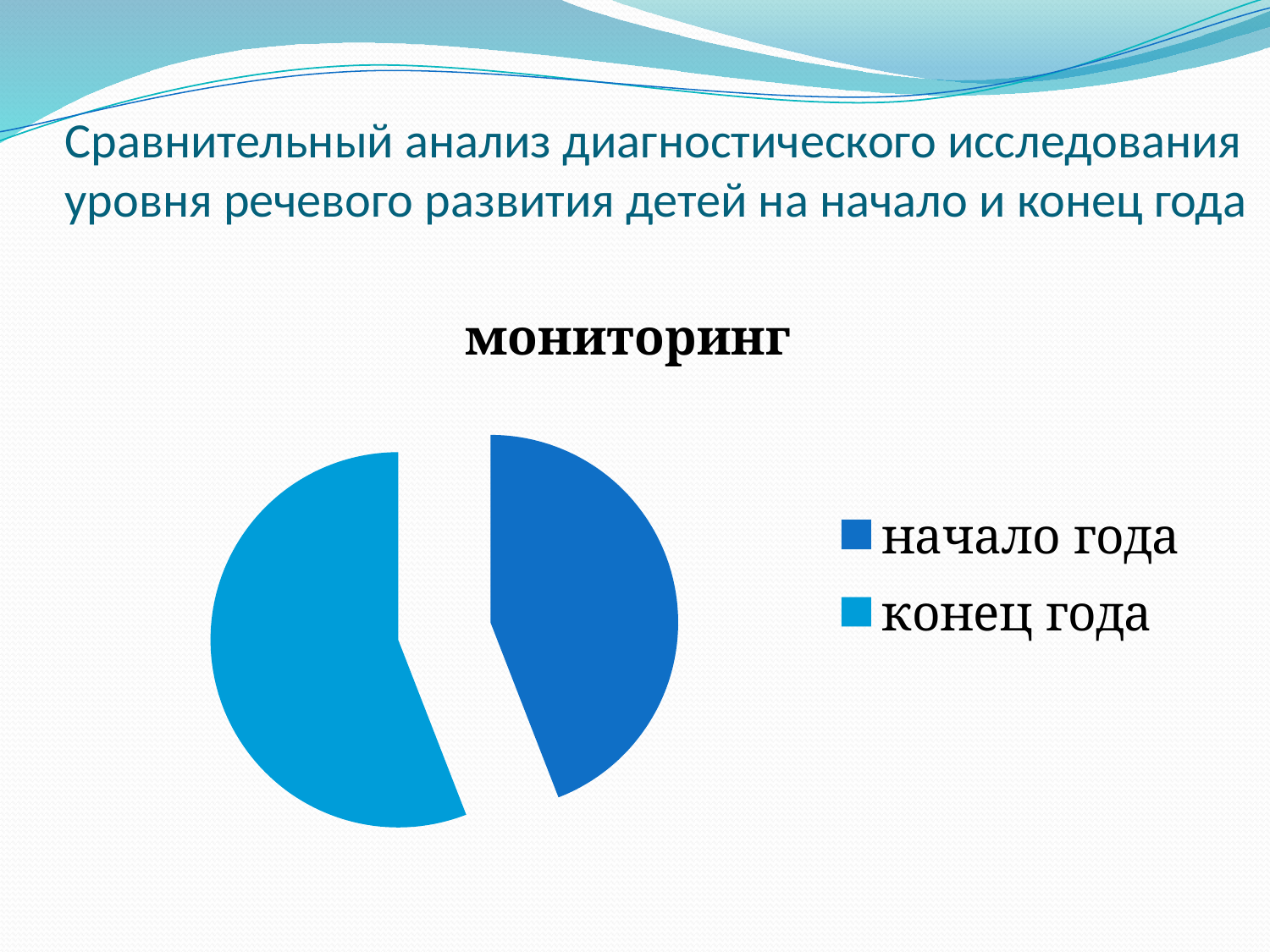
What is the title of the chart? мониторинг What kind of chart is shown on the slide? pie chart Which category has the largest slice in the pie chart? конец года Which category has the smallest slice in the pie chart? начало года Which slice of the pie chart is larger, начало года or конец года? конец года What are the two categories listed in the legend? начало года, конец года How many slices does the pie chart have? 2 How many entries does the legend list? 2